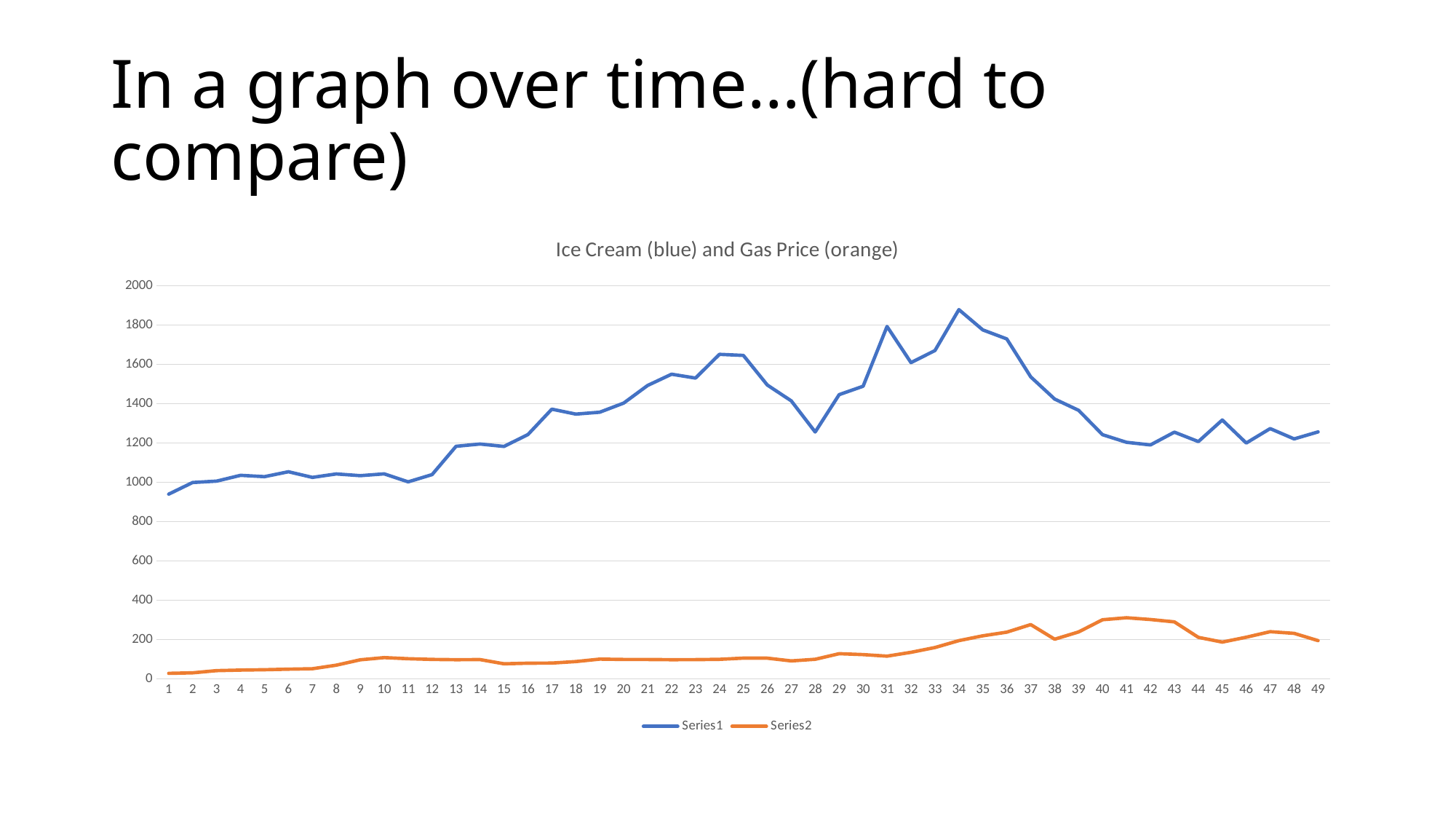
At point 20, which series has the larger value, Series1 or Series2? Series1 How many series does the legend list? 2 Is the value for Series1 at point 34 greater or less than 1800? greater At which x-axis point does Series1 have its lowest value? 1 Which colour is used for Series2 in the chart? orange Does Series2 generally rise or fall from point 1 to point 41? rise Is the value for Series1 at point 1 greater or less than 1000? less At which x-axis point does Series1 reach its highest value? 34 Is the value for Series2 at point 37 greater or less than 200? greater What is the title of the chart? Ice Cream (blue) and Gas Price (orange) What kind of chart is shown on the slide? line chart How many points are plotted along the x axis for each series? 49